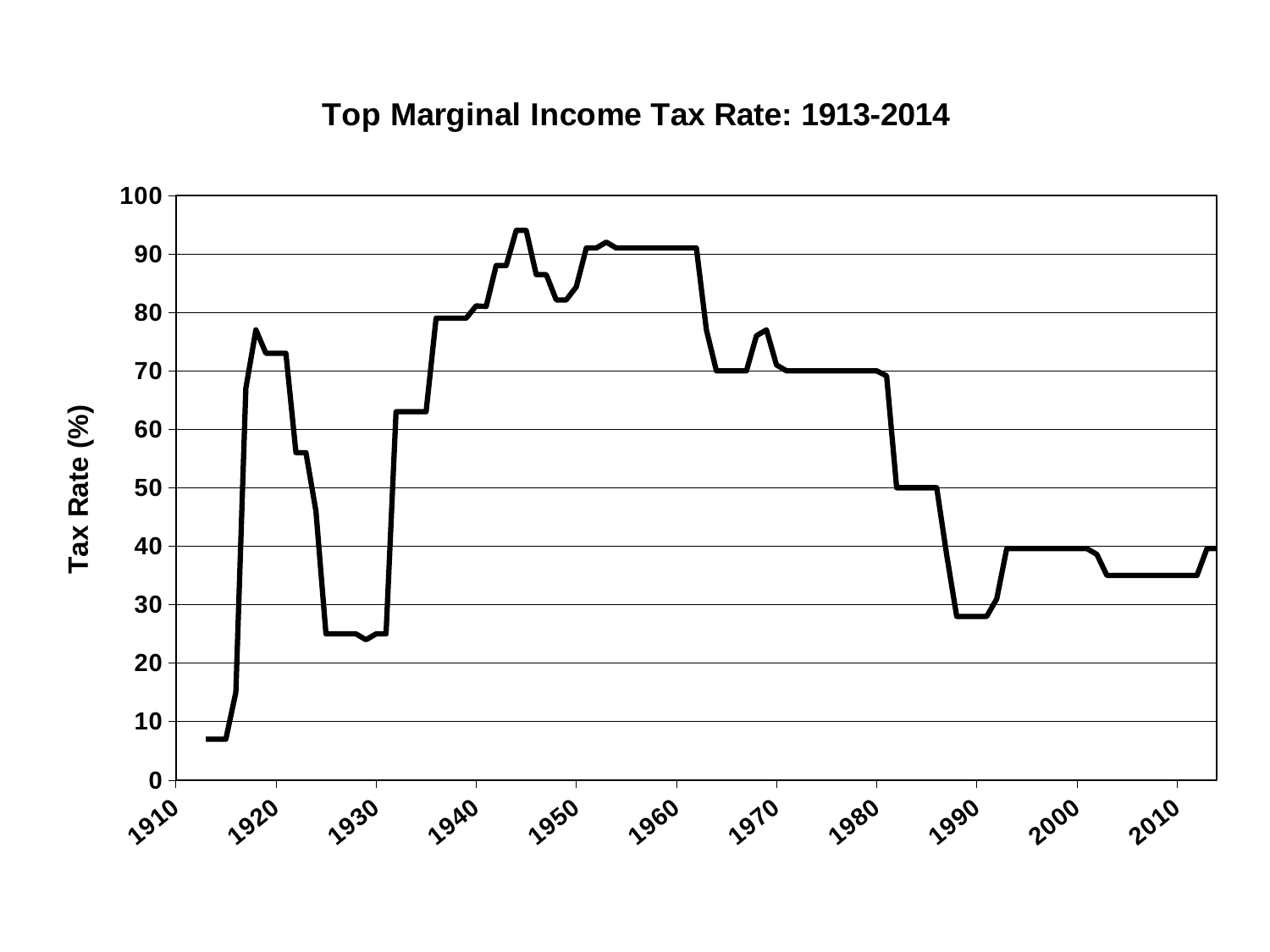
What is the tax rate shown for 1985? 50 What is the tax rate shown for 1975? 70 What is the title of the chart? Top Marginal Income Tax Rate: 1913-2014 Is the tax rate for 1930 greater or less than 30? less Is the tax rate for 1920 greater or less than 70? greater Is the tax rate for 1990 greater or less than 30? less What is the label on the vertical axis? Tax Rate (%) Which is larger, the tax rate in 1960 or the tax rate in 2000? 1960 Does the tax rate rise or fall between 1980 and 1990? fall What kind of chart is shown on the slide? line chart